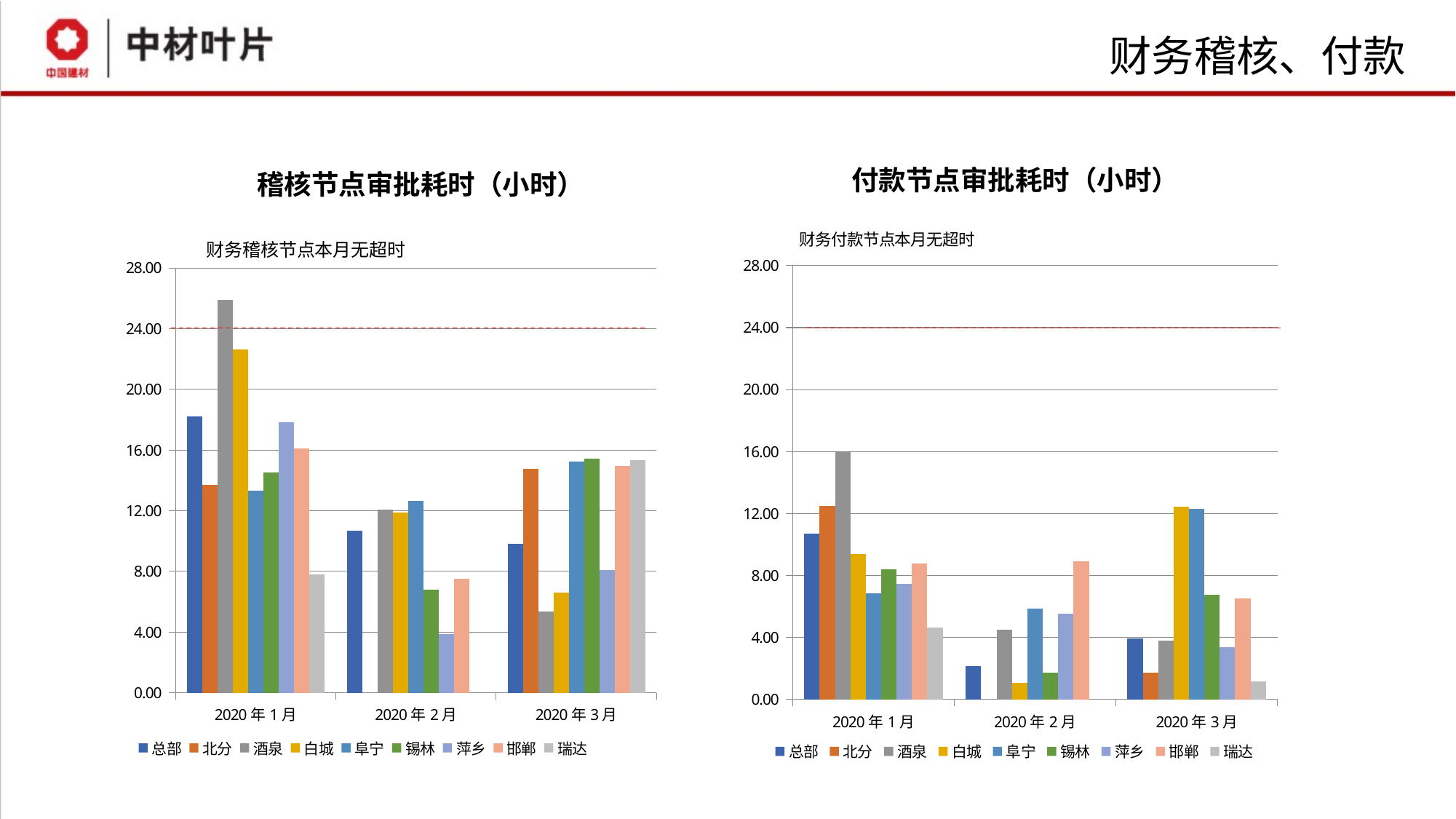
In the left chart 稽核节点审批耗时（小时）, is the value for 酒泉 in 2020年1月 greater or less than 24.00? greater In the left chart 稽核节点审批耗时（小时）, which series has the lowest value in 2020年2月? 萍乡 How many month categories are shown on the x axis of the left chart 稽核节点审批耗时（小时）? 3 In the right chart 付款节点审批耗时（小时）, is the value for 总部 in 2020年1月 greater or less than 8.00? greater In the right chart 付款节点审批耗时（小时）, which series has the highest value in 2020年2月? 邯郸 What type of chart is the left chart titled 稽核节点审批耗时（小时）? bar chart In the left chart 稽核节点审批耗时（小时）, is the value for 总部 in 2020年1月 greater or less than 16.00? greater In the right chart 付款节点审批耗时（小时）, which is larger in 2020年3月: 白城 or 锡林? 白城 In the right chart 付款节点审批耗时（小时）, which series has the highest value in 2020年1月? 酒泉 At what value is the red dashed horizontal line drawn in the left chart 稽核节点审批耗时（小时）? 24.00 How many series does the legend of the right chart 付款节点审批耗时（小时） list? 9 In the left chart 稽核节点审批耗时（小时）, which series has the highest value in 2020年1月? 酒泉